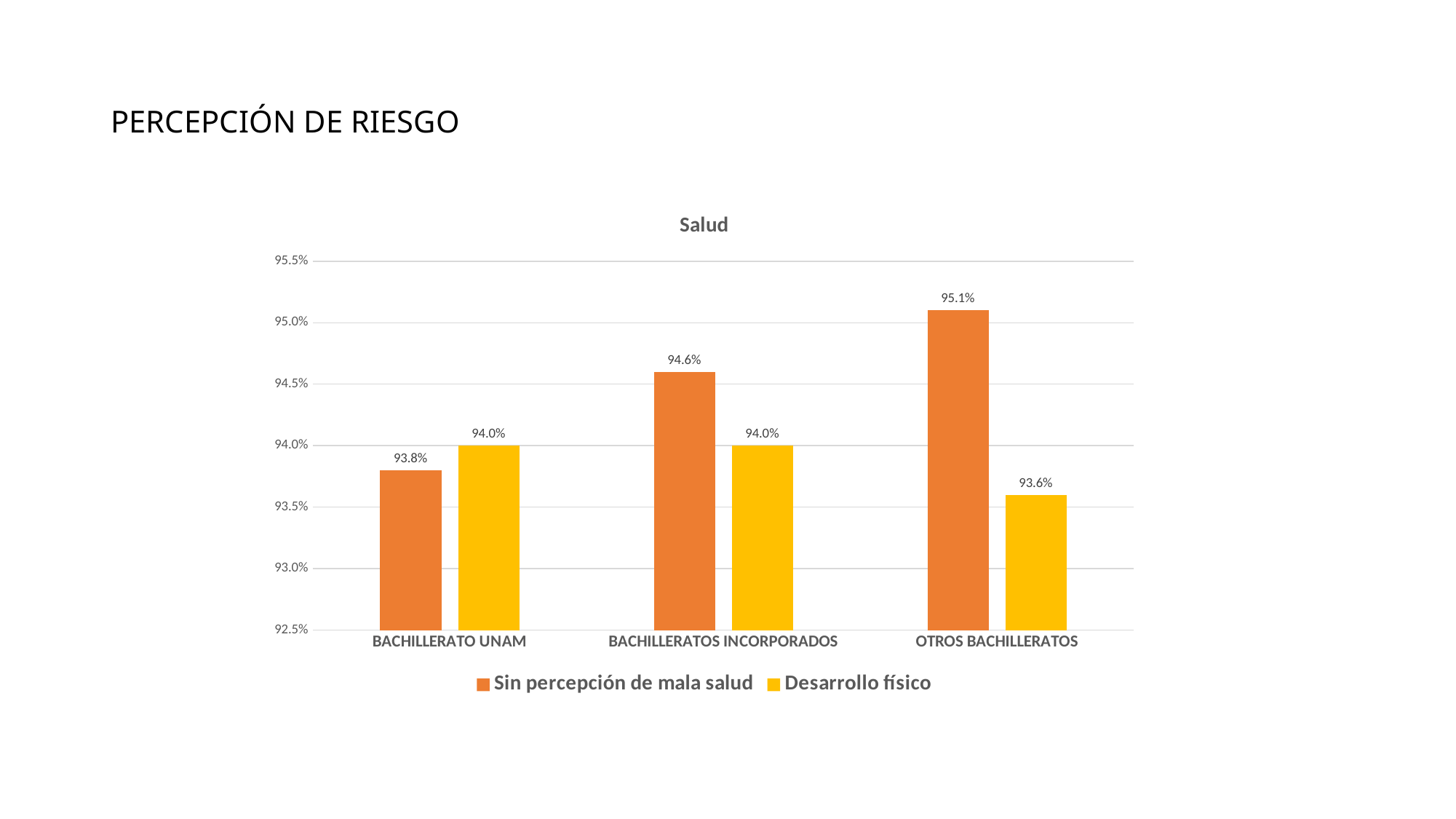
For BACHILLERATO UNAM, which series has the larger value: Sin percepción de mala salud or Desarrollo físico? Desarrollo físico How many series does the legend list? 2 What is the value for Sin percepción de mala salud for BACHILLERATOS INCORPORADOS? 94.6% Which category has the lowest value for Desarrollo físico? OTROS BACHILLERATOS How many categories are shown on the x axis? 3 Is the value for Sin percepción de mala salud for OTROS BACHILLERATOS greater or less than 95.0%? greater What is the title of the chart? Salud What is the difference between Sin percepción de mala salud and Desarrollo físico for OTROS BACHILLERATOS? 1.5% What kind of chart is shown on the slide? bar chart Which category has the highest value for Sin percepción de mala salud? OTROS BACHILLERATOS What is the value for Desarrollo físico for OTROS BACHILLERATOS? 93.6% What is the value for Sin percepción de mala salud for BACHILLERATO UNAM? 93.8%